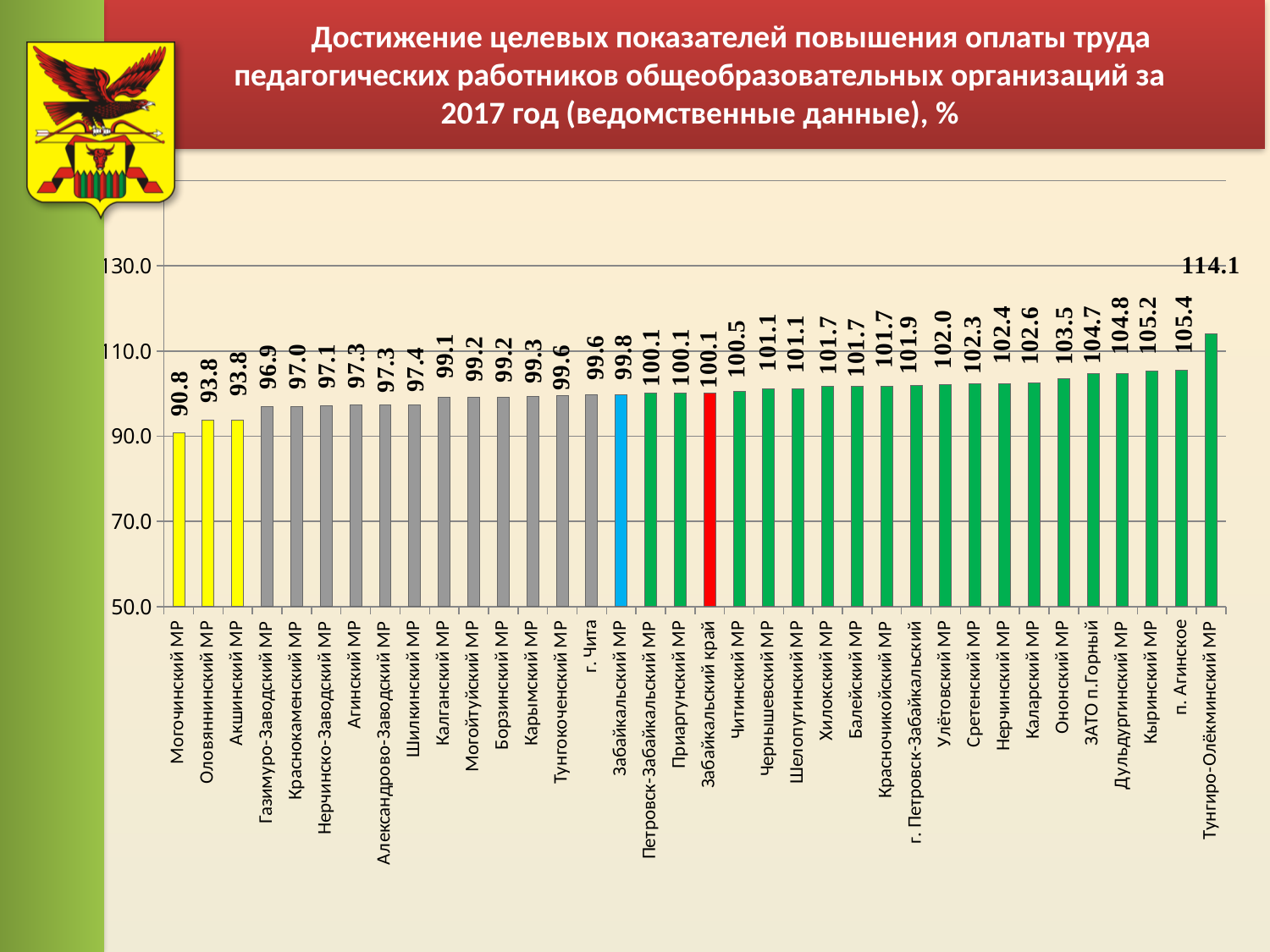
What is the value for Забайкальский край? 100.1 What is the value for г. Чита? 99.6 What kind of chart is shown on the slide? bar chart Do the values rise or fall from left to right along the x axis? rise What is the value for Тунгиро-Олёкминский МР? 114.1 Is the value for Могочинский МР greater or less than 110.0? less Which category has the highest value? Тунгиро-Олёкминский МР What is the difference between the values for Тунгиро-Олёкминский МР and Могочинский МР? 23.3 How many categories are plotted on the chart? 36 Which category has the lowest value? Могочинский МР Which is larger, the value for Кыринский МР or the value for Каларский МР? Кыринский МР What is the value for Ононский МР? 103.5